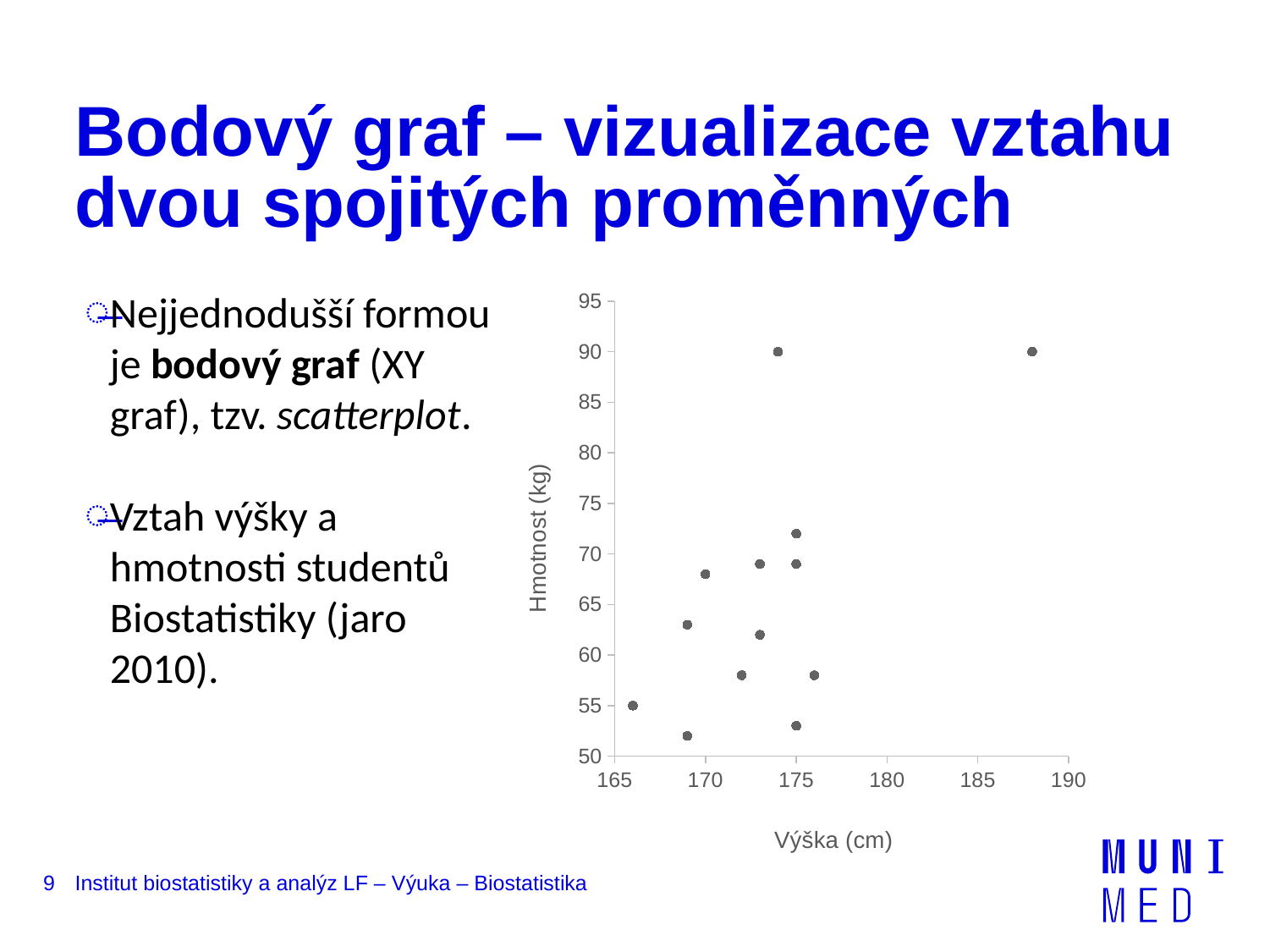
Is the largest height (Výška) value plotted greater or less than 185? greater How many data points are plotted in the scatter plot? 13 Is the smallest height (Výška) value plotted greater or less than 170? less What is the label of the horizontal axis of the chart? Výška (cm) Is the highest weight (Hmotnost) value plotted greater or less than 85? greater What kind of chart is shown on the slide? scatter plot What is the label of the vertical axis of the chart? Hmotnost (kg) What is the lowest value shown on the vertical (Hmotnost) axis? 50